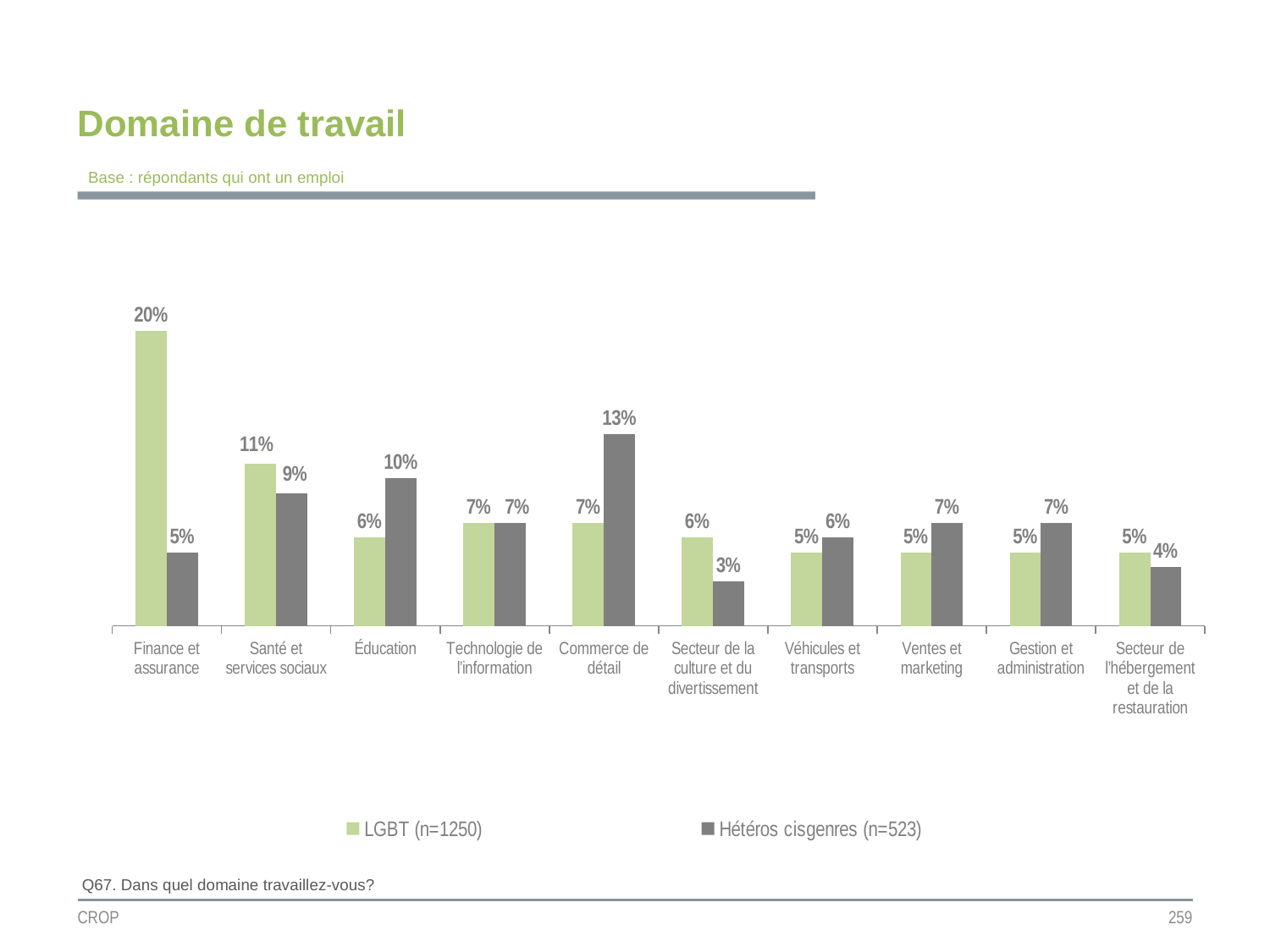
Which series has the larger value in Santé et services sociaux? LGBT (n=1250) What is the value for LGBT (n=1250) in Finance et assurance? 20% Which category has the highest value for LGBT (n=1250)? Finance et assurance What is the value for Hétéros cisgenres (n=523) in Commerce de détail? 13% How many series does the legend list? 2 What is the value for Hétéros cisgenres (n=523) in Secteur de la culture et du divertissement? 3% How many categories are shown on the x axis? 10 What is the title of the slide? Domaine de travail What is the difference between the LGBT (n=1250) and Hétéros cisgenres (n=523) values in Finance et assurance? 15% Which category has the lowest value for Hétéros cisgenres (n=523)? Secteur de la culture et du divertissement Which series has the larger value in Éducation? Hétéros cisgenres (n=523) What kind of chart is shown on the slide? Bar chart